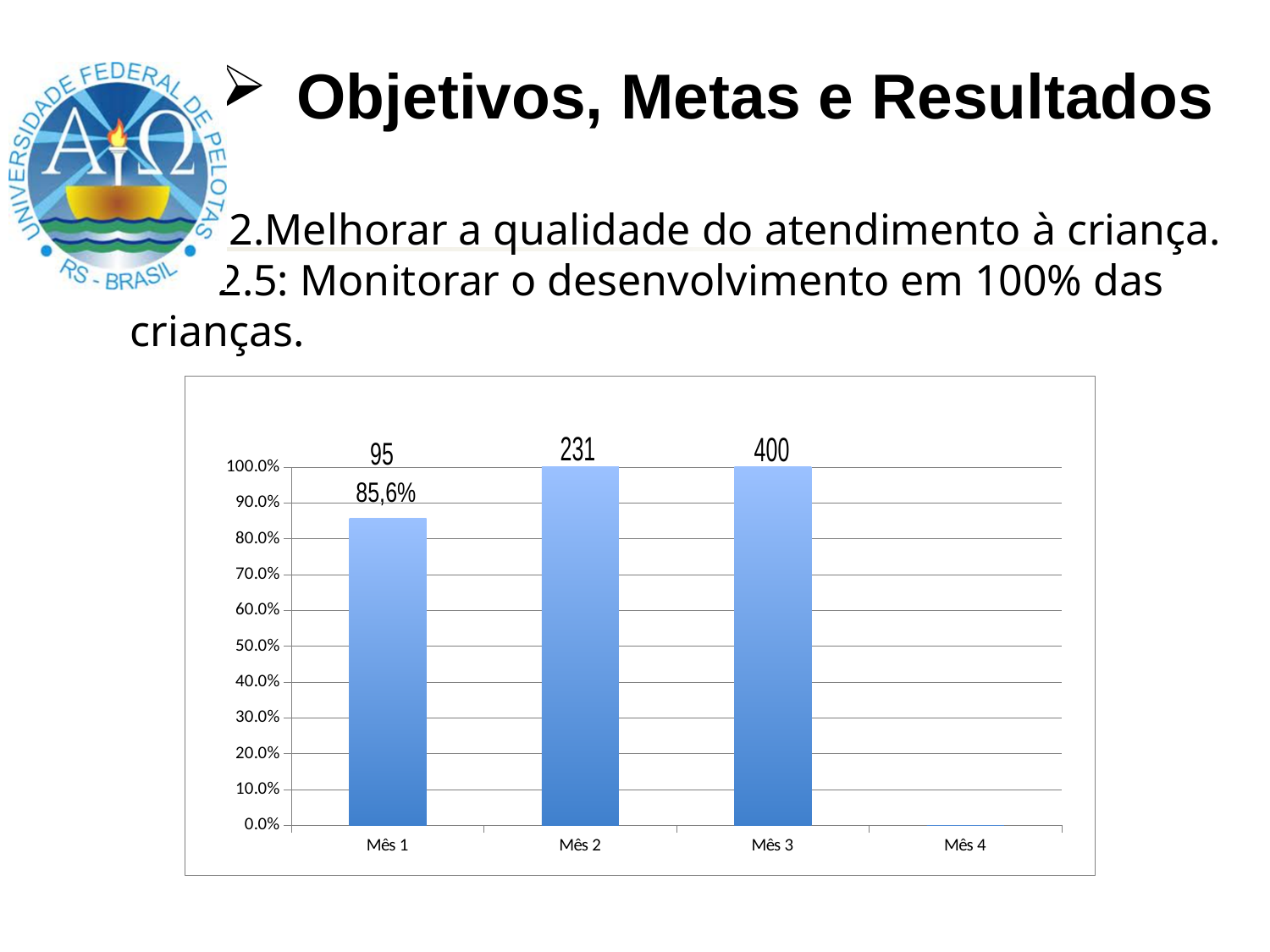
Which month has no bar plotted in the chart? Mês 4 What number is printed above the bar for Mês 2? 231 How many categories are shown on the x axis of the chart? 4 Do the bar values rise or fall from Mês 1 to Mês 3? rise What percentage is shown for Mês 1? 85,6% Is the value for Mês 1 greater or less than 90.0%? less What is the difference between the numbers printed above the bars for Mês 3 and Mês 2? 169 What number is printed above the bar for Mês 3? 400 Which bar is taller, Mês 1 or Mês 2? Mês 2 What kind of chart is shown on the slide? bar chart What number is printed above the bar for Mês 1? 95 What percentage does the bar for Mês 3 reach? 100.0%